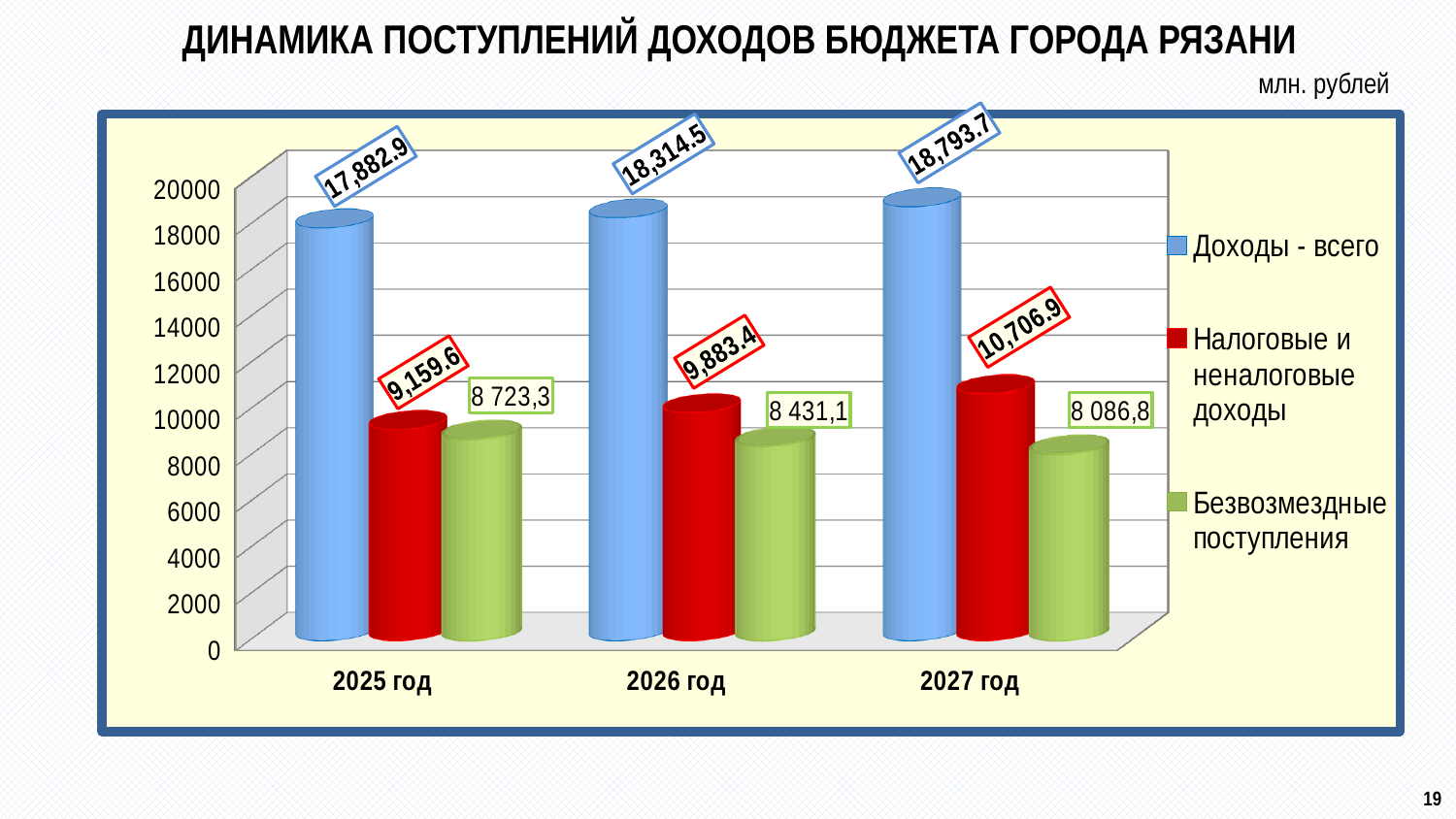
What is the difference between Доходы - всего in 2027 год and in 2025 год? 910.8 What is the value of Доходы - всего for 2025 год? 17,882.9 What is the value of Безвозмездные поступления for 2026 год? 8 431,1 In which year is Безвозмездные поступления the lowest? 2027 год What is the difference between Налоговые и неналоговые доходы in 2027 год and in 2025 год? 1,547.3 How many series does the legend list? 3 What is the value of Налоговые и неналоговые доходы for 2027 год? 10,706.9 Do the values of Безвозмездные поступления rise or fall from 2025 год to 2027 год? Fall How many years are shown on the x axis? 3 In which year is Доходы - всего the highest? 2027 год Which is larger in 2026 год: Налоговые и неналоговые доходы or Безвозмездные поступления? Налоговые и неналоговые доходы What kind of chart is shown on the slide? Bar chart